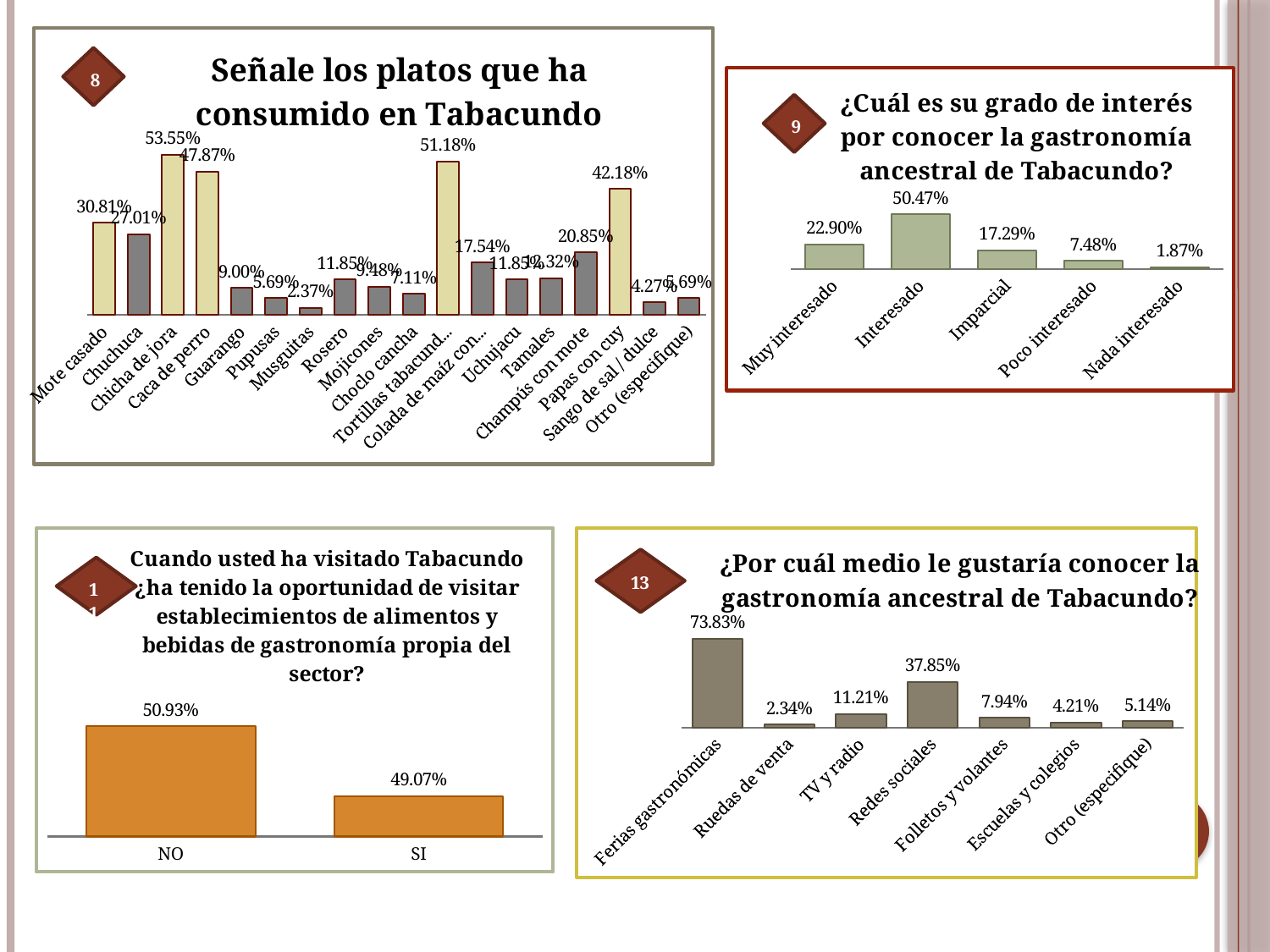
In the chart '¿Cuál es su grado de interés por conocer la gastronomía ancestral de Tabacundo?', what is the value for Nada interesado? 1.87% In the chart '¿Cuál es su grado de interés por conocer la gastronomía ancestral de Tabacundo?', what is the difference between Muy interesado and Imparcial? 5.61% In the chart 'Señale los platos que ha consumido en Tabacundo', which dish has the lowest value? Musguitas In the bottom-left chart about visiting food and drink establishments in Tabacundo, what is the value for NO? 50.93% In the chart 'Señale los platos que ha consumido en Tabacundo', what is the value for Papas con cuy? 42.18% In the chart '¿Por cuál medio le gustaría conocer la gastronomía ancestral de Tabacundo?', what is the value for Redes sociales? 37.85% In the chart '¿Cuál es su grado de interés por conocer la gastronomía ancestral de Tabacundo?', which category has the highest value? Interesado What kind of chart is '¿Por cuál medio le gustaría conocer la gastronomía ancestral de Tabacundo?'? Bar chart In the bottom-left chart about visiting food and drink establishments in Tabacundo, which is larger, NO or SI? NO In the chart 'Señale los platos que ha consumido en Tabacundo', what is the value for Chicha de jora? 53.55% In the chart '¿Por cuál medio le gustaría conocer la gastronomía ancestral de Tabacundo?', which medium has the highest value? Ferias gastronómicas In the chart '¿Cuál es su grado de interés por conocer la gastronomía ancestral de Tabacundo?', how many categories are shown? 5